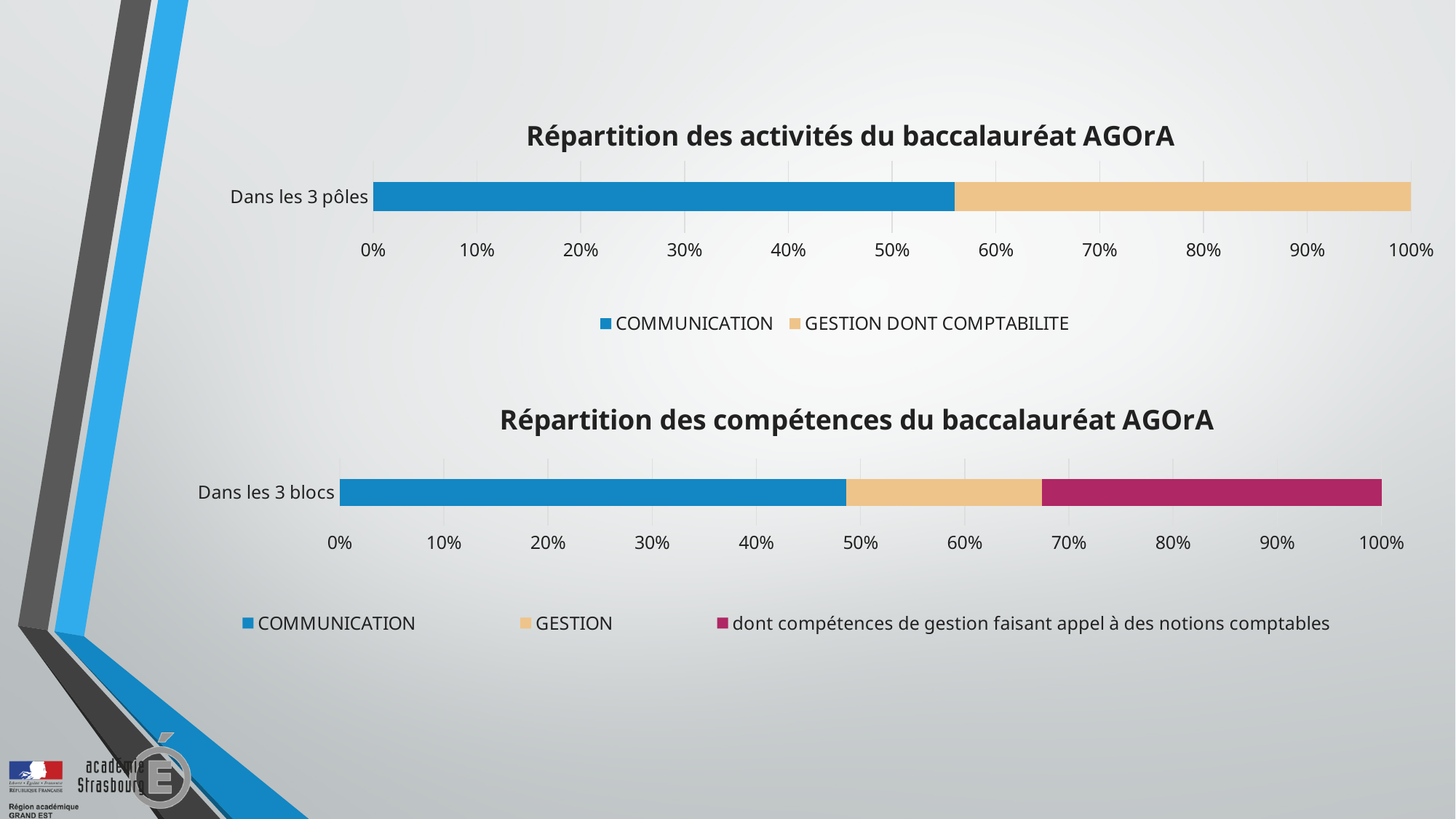
In the 'Répartition des activités du baccalauréat AGOrA' chart, is the value for COMMUNICATION greater or less than 50%? greater In the 'Répartition des activités du baccalauréat AGOrA' chart, which is larger, COMMUNICATION or GESTION DONT COMPTABILITE? COMMUNICATION What kind of chart is the 'Répartition des activités du baccalauréat AGOrA' chart? Stacked bar chart What colour represents COMMUNICATION in the 'Répartition des compétences du baccalauréat AGOrA' chart? Blue In the 'Répartition des compétences du baccalauréat AGOrA' chart, is the value for GESTION greater or less than 30%? less In the 'Répartition des compétences du baccalauréat AGOrA' chart, which series has the smallest segment? GESTION In the 'Répartition des compétences du baccalauréat AGOrA' chart, is the value for COMMUNICATION greater or less than 40%? greater What is the category label on the y axis of the 'Répartition des activités du baccalauréat AGOrA' chart? Dans les 3 pôles In the 'Répartition des compétences du baccalauréat AGOrA' chart, which is larger, GESTION or 'dont compétences de gestion faisant appel à des notions comptables'? dont compétences de gestion faisant appel à des notions comptables How many series does the legend of the 'Répartition des activités du baccalauréat AGOrA' chart list? 2 How many categories are shown on the y axis of the 'Répartition des compétences du baccalauréat AGOrA' chart? 1 How many series does the legend of the 'Répartition des compétences du baccalauréat AGOrA' chart list? 3